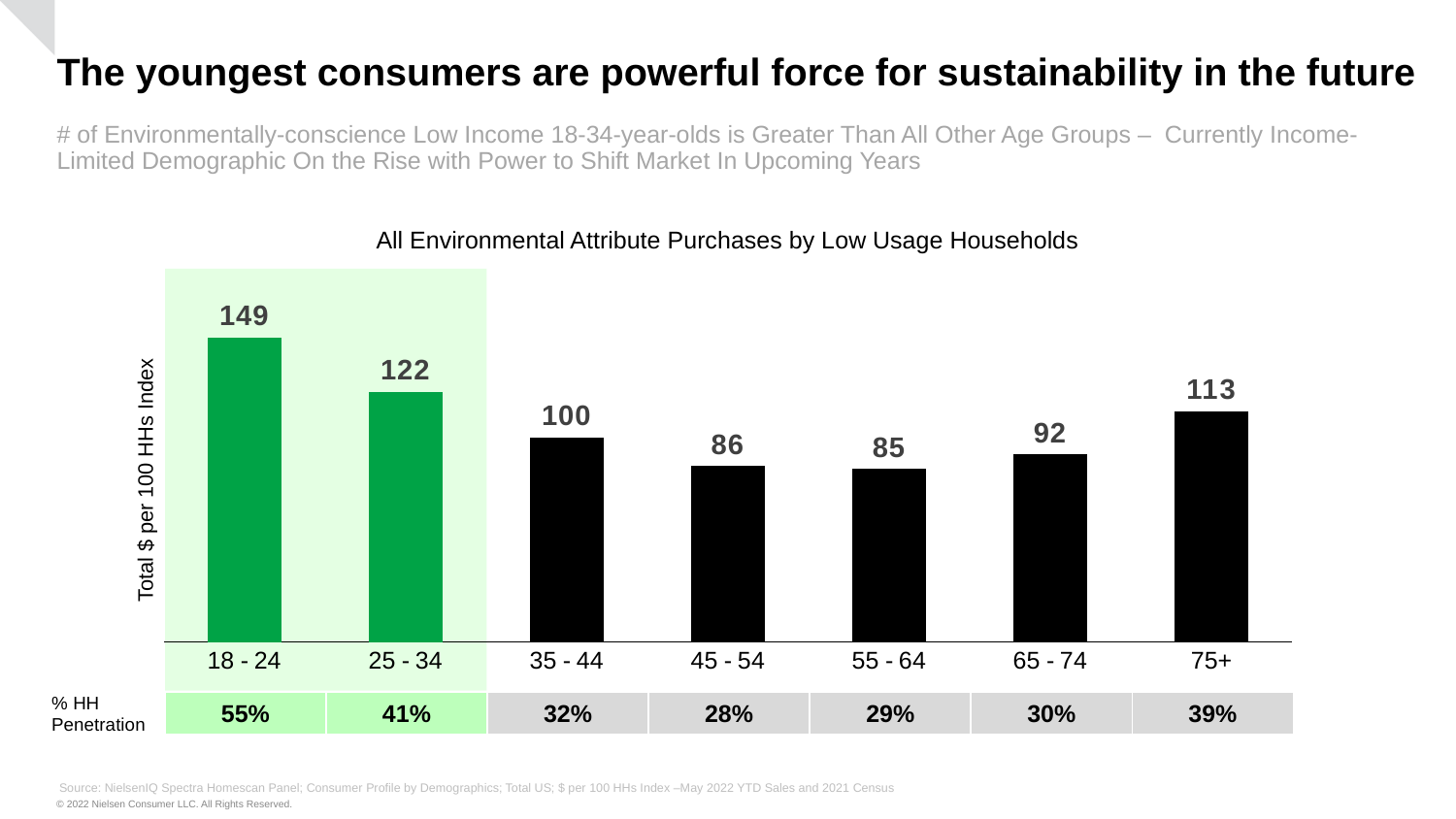
What is the Total $ per 100 HHs Index value for the 18 - 24 age group? 149 Which age group has the highest index value? 18 - 24 What is the difference between the index values for the 18 - 24 and 25 - 34 age groups? 27 Which has a higher index value, the 75+ group or the 35 - 44 group? 75+ What is the index value for the 65 - 74 age group? 92 Which age group has the lowest % HH Penetration? 45 - 54 Which age group has the lowest index value? 55 - 64 What is the title of the chart? All Environmental Attribute Purchases by Low Usage Households What is the difference in % HH Penetration between the 18 - 24 and 75+ age groups? 16% What is the % HH Penetration for the 25 - 34 age group? 41% What type of chart is shown on the slide? Bar chart How many age groups are shown on the chart? 7